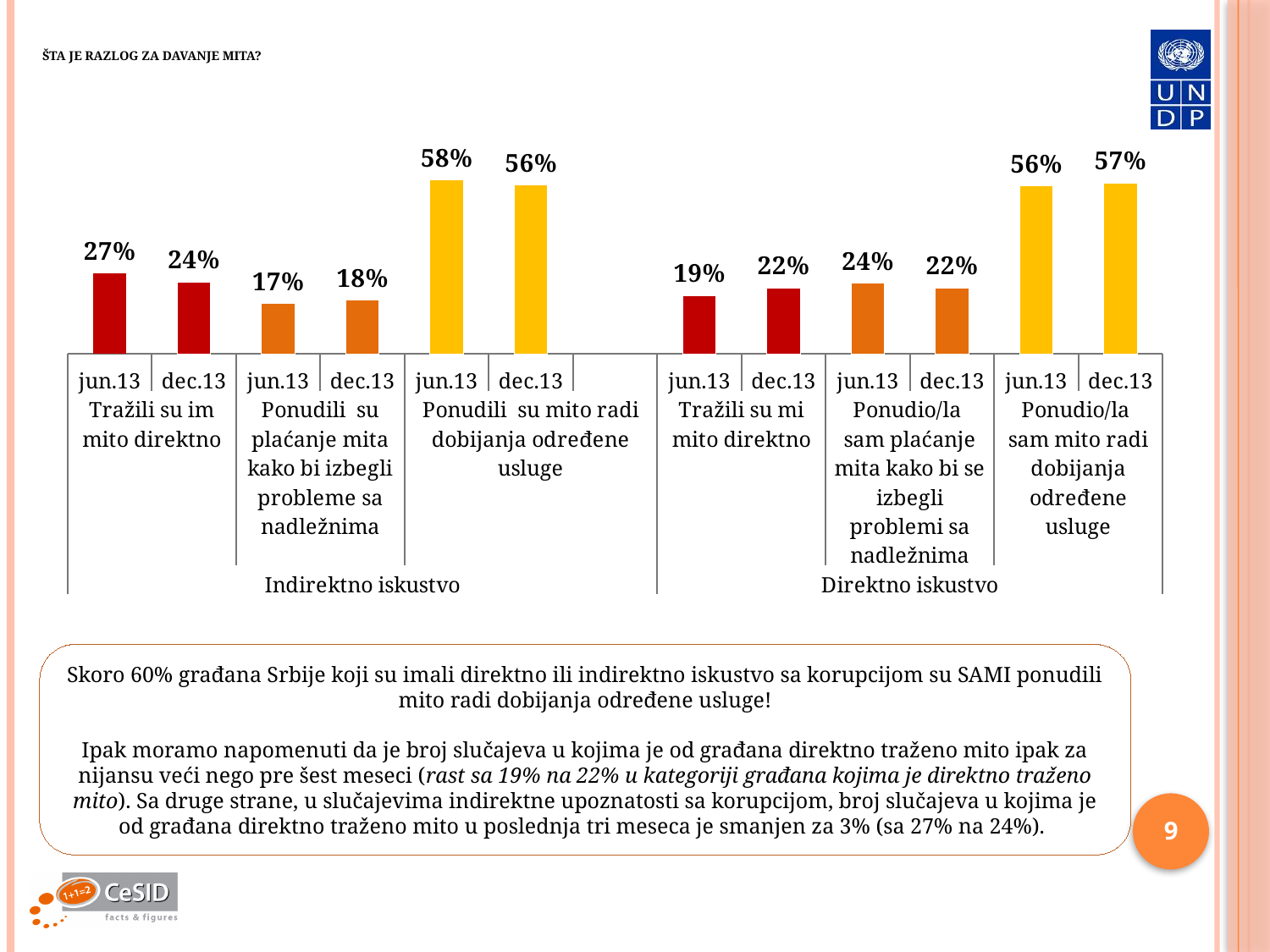
How many bars are plotted in the chart? 12 What is the value for dec.13 under "Ponudili su plaćanje mita kako bi izbegli probleme sa nadležnima"? 18% What is the value for dec.13 under "Ponudio/la sam mito radi dobijanja određene usluge"? 57% Which bar has the highest value in the whole chart? jun.13, Ponudili su mito radi dobijanja određene usluge (Indirektno iskustvo), 58% From jun.13 to dec.13, does the value for "Ponudio/la sam plaćanje mita kako bi se izbegli problemi sa nadležnima" rise or fall? fall What is the difference between the jun.13 and dec.13 values for "Tražili su mi mito direktno" in the Direktno iskustvo group? 3% Which bar has the lowest value in the whole chart? jun.13, Ponudili su plaćanje mita kako bi izbegli probleme sa nadležnima (Indirektno iskustvo), 17% Which is larger: the jun.13 value for "Ponudili su mito radi dobijanja određene usluge" (Indirektno) or the jun.13 value for "Ponudio/la sam mito radi dobijanja određene usluge" (Direktno)? Indirektno, 58% What is the value for jun.13 under "Tražili su mi mito direktno" in the Direktno iskustvo group? 19% What is the value for dec.13 under "Tražili su im mito direktno" in the Indirektno iskustvo group? 24% What kind of chart is shown on the slide? bar chart What is the value for jun.13 under "Tražili su im mito direktno" in the Indirektno iskustvo group? 27%